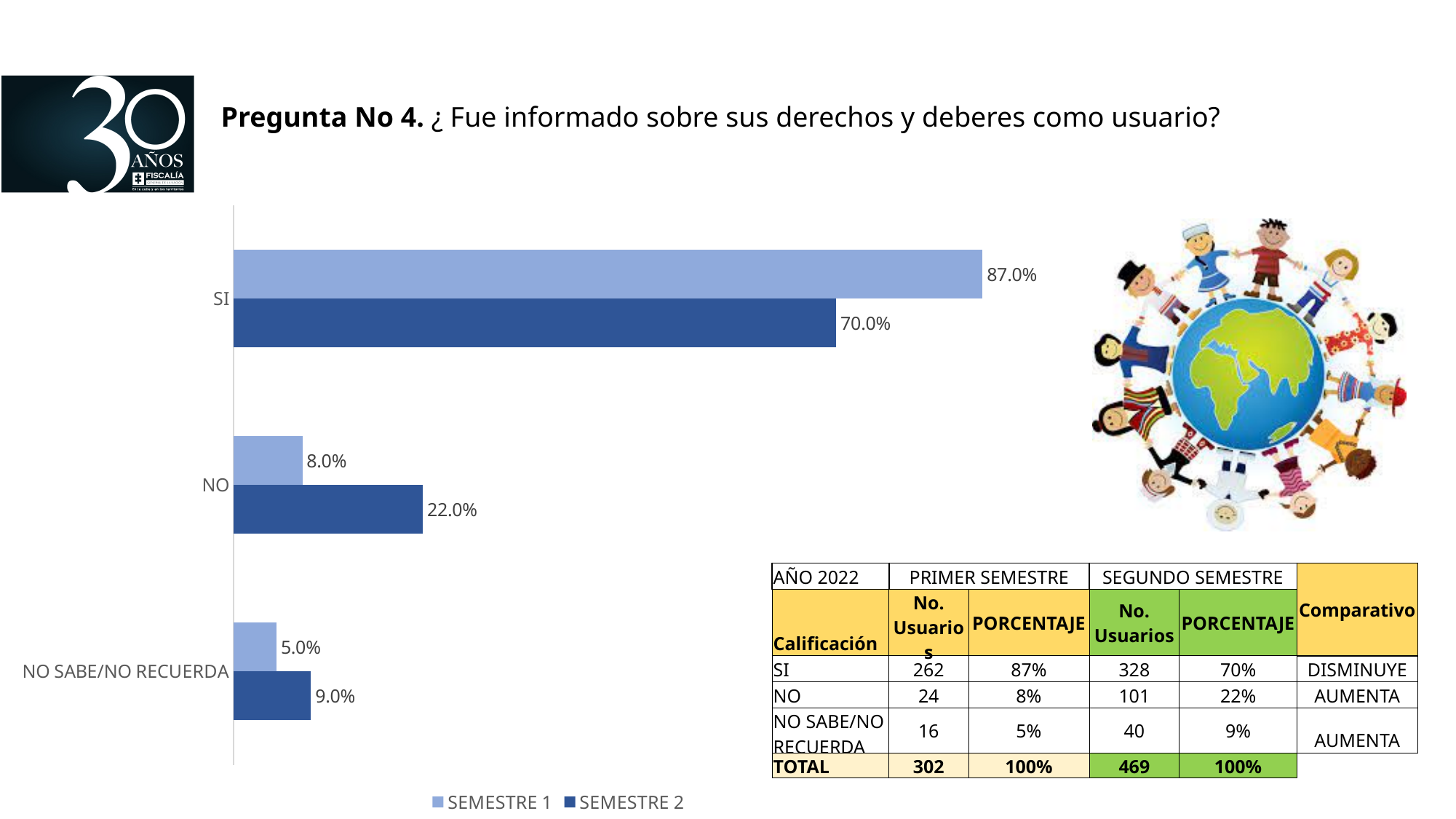
How many series does the legend list? 2 What is the value for SI in the SEMESTRE 2 series? 70.0% What is the value for NO SABE/NO RECUERDA in the SEMESTRE 1 series? 5.0% What is the value for SI in the SEMESTRE 1 series? 87.0% For NO, which series has the larger value, SEMESTRE 1 or SEMESTRE 2? SEMESTRE 2 How many categories are shown on the chart? 3 What is the difference between the SEMESTRE 1 and SEMESTRE 2 values for SI? 17.0% What kind of chart is shown on the slide? Bar chart Which category has the lowest value in the SEMESTRE 2 series? NO SABE/NO RECUERDA What is the value for NO in the SEMESTRE 2 series? 22.0% Which category has the highest value in the SEMESTRE 1 series? SI What is the difference between the SEMESTRE 2 and SEMESTRE 1 values for NO? 14.0%